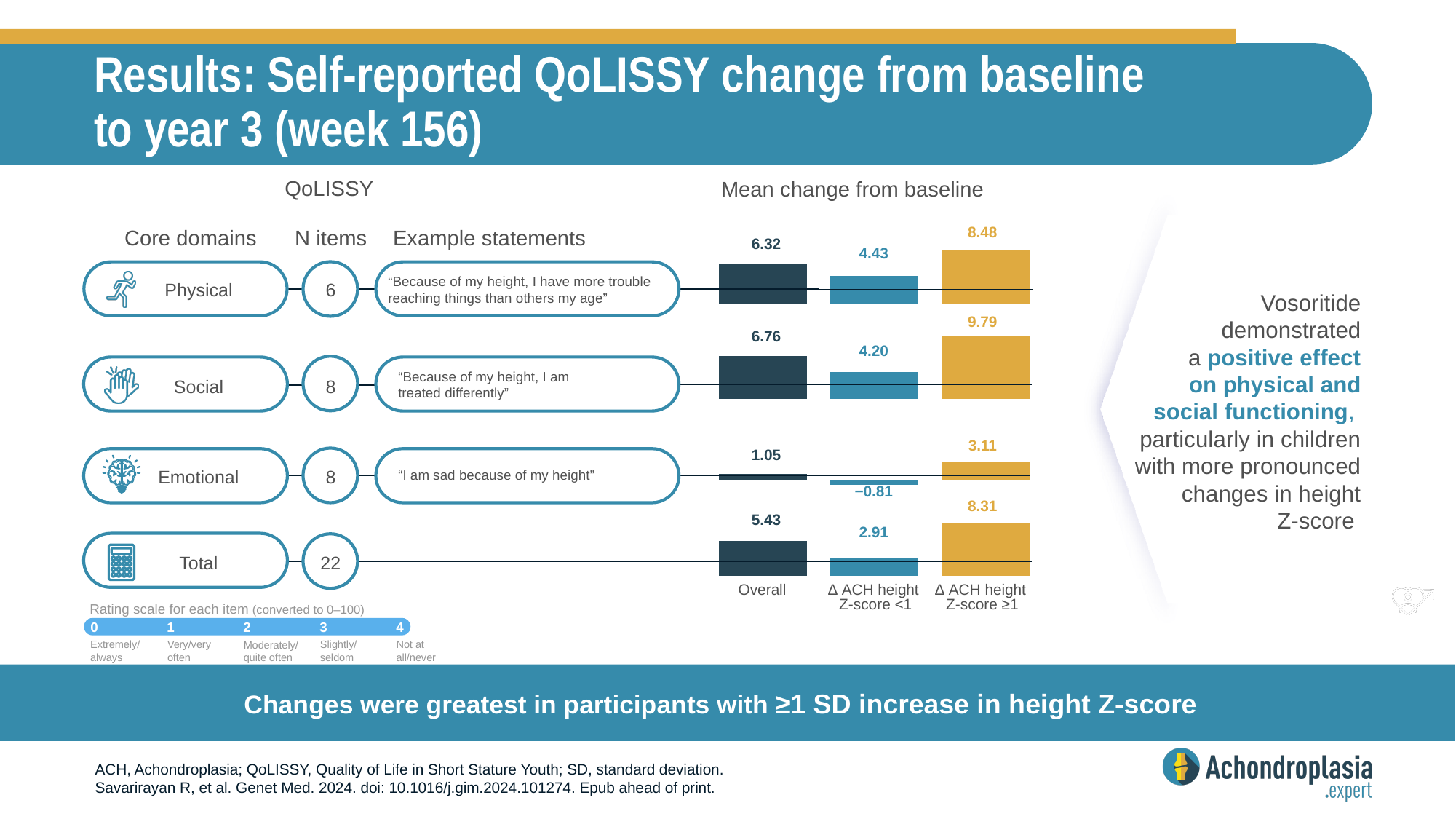
What is the mean change from baseline for the Total score in the Δ ACH height Z-score ≥1 group? 8.31 What is the mean change from baseline for the Physical domain in the Overall group? 6.32 Which is larger for the Physical domain: the Overall mean change or the Δ ACH height Z-score <1 mean change? Overall Which domain has the highest mean change from baseline in the Δ ACH height Z-score ≥1 group? Social What type of chart is used to show the mean change from baseline? Bar chart What is the mean change from baseline for the Social domain in the Δ ACH height Z-score ≥1 group? 9.79 What colour are the bars for the Δ ACH height Z-score ≥1 group? Yellow/gold How many groups (bar series) are compared for each domain in the mean change from baseline chart? 3 What is the difference between the Social domain mean change in the Δ ACH height Z-score ≥1 group and the Δ ACH height Z-score <1 group? 5.59 How many groups of bars (domains) are shown in the mean change from baseline chart? 4 What is the mean change from baseline for the Emotional domain in the Δ ACH height Z-score <1 group? −0.81 Which domain has the lowest mean change from baseline in the Overall group? Emotional